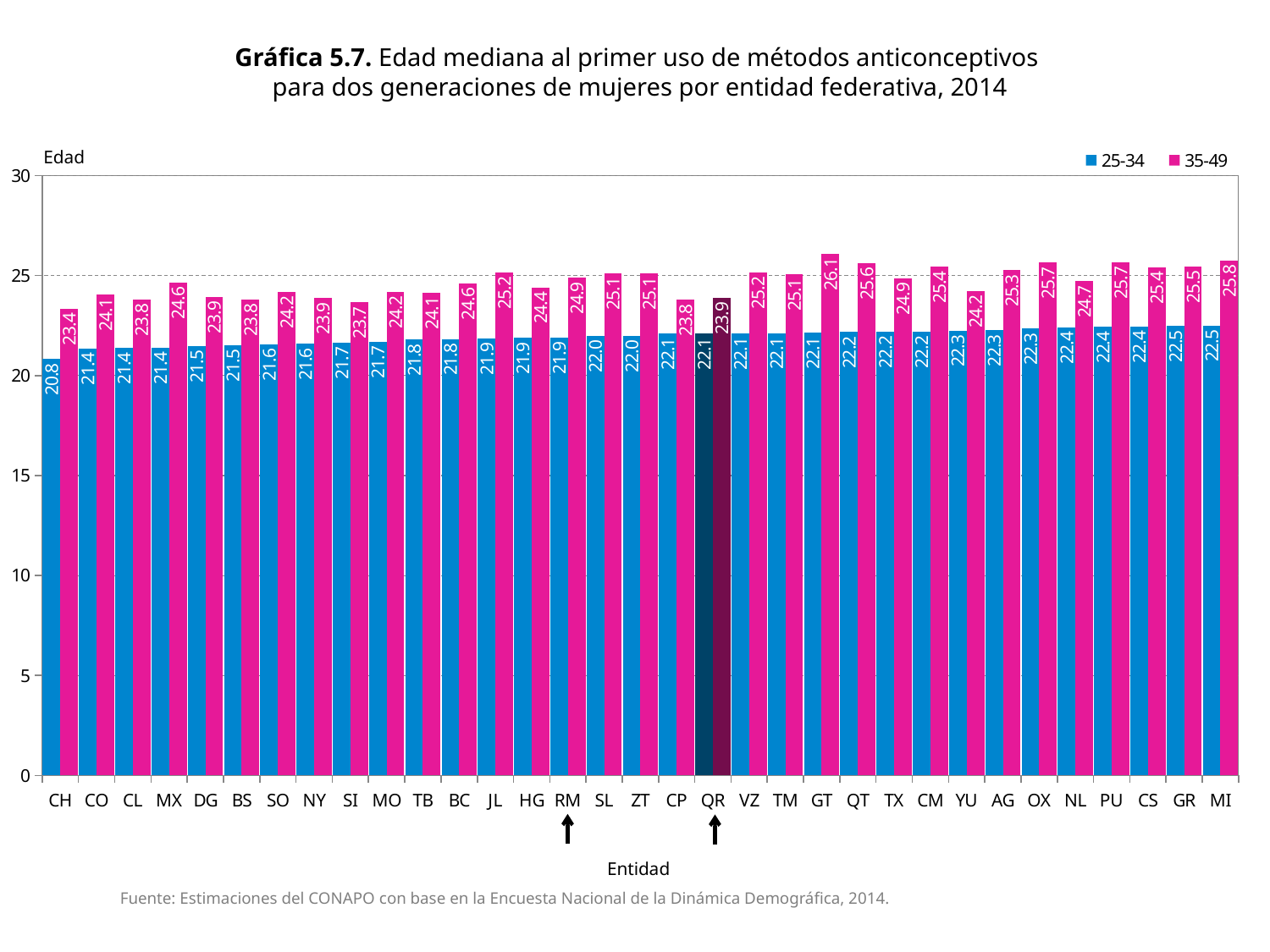
What is the value for the 25-34 series for CH? 20.8 How many series does the legend list? 2 How many entities are shown on the x axis? 33 Which is larger, the 35-49 value for JL or the 35-49 value for HG? JL What is the value for the 25-34 series for RM? 21.9 Which entity has the lowest value in the 25-34 series? CH Which entity has the highest value in the 35-49 series? GT What kind of chart is this? Bar chart What is the value for the 35-49 series for QR? 23.9 Do the 25-34 values rise or fall from CH to MI along the x axis? Rise What is the difference between the 35-49 and 25-34 values for MI? 3.3 What is the value for the 35-49 series for GT? 26.1